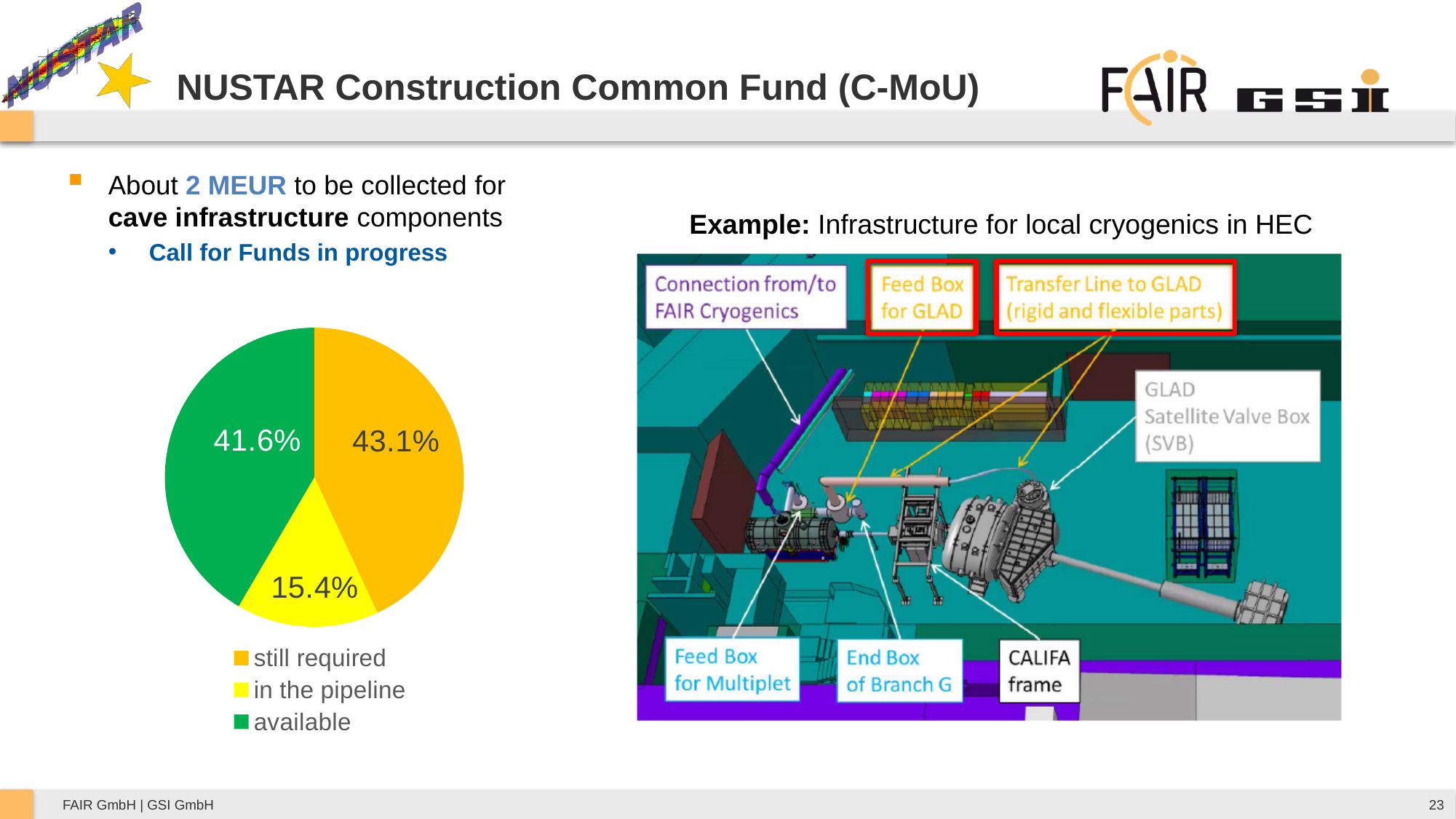
In the pie chart, what share is labelled 'available'? 41.6% What colour is the 'available' slice in the pie chart? green What is the difference in percentage points between the 'available' and 'in the pipeline' slices? 26.2 Which slice of the pie chart is the smallest? in the pipeline Which is larger in the pie chart, 'still required' or 'available'? still required What kind of chart is shown on the left of the slide? pie chart In the pie chart, what share is labelled 'still required'? 43.1% What is the difference in percentage points between the 'still required' and 'available' slices? 1.5 In the pie chart, what share is labelled 'in the pipeline'? 15.4% How many slices does the pie chart have? 3 How many entries does the pie chart legend list? 3 Which slice of the pie chart is the largest? still required